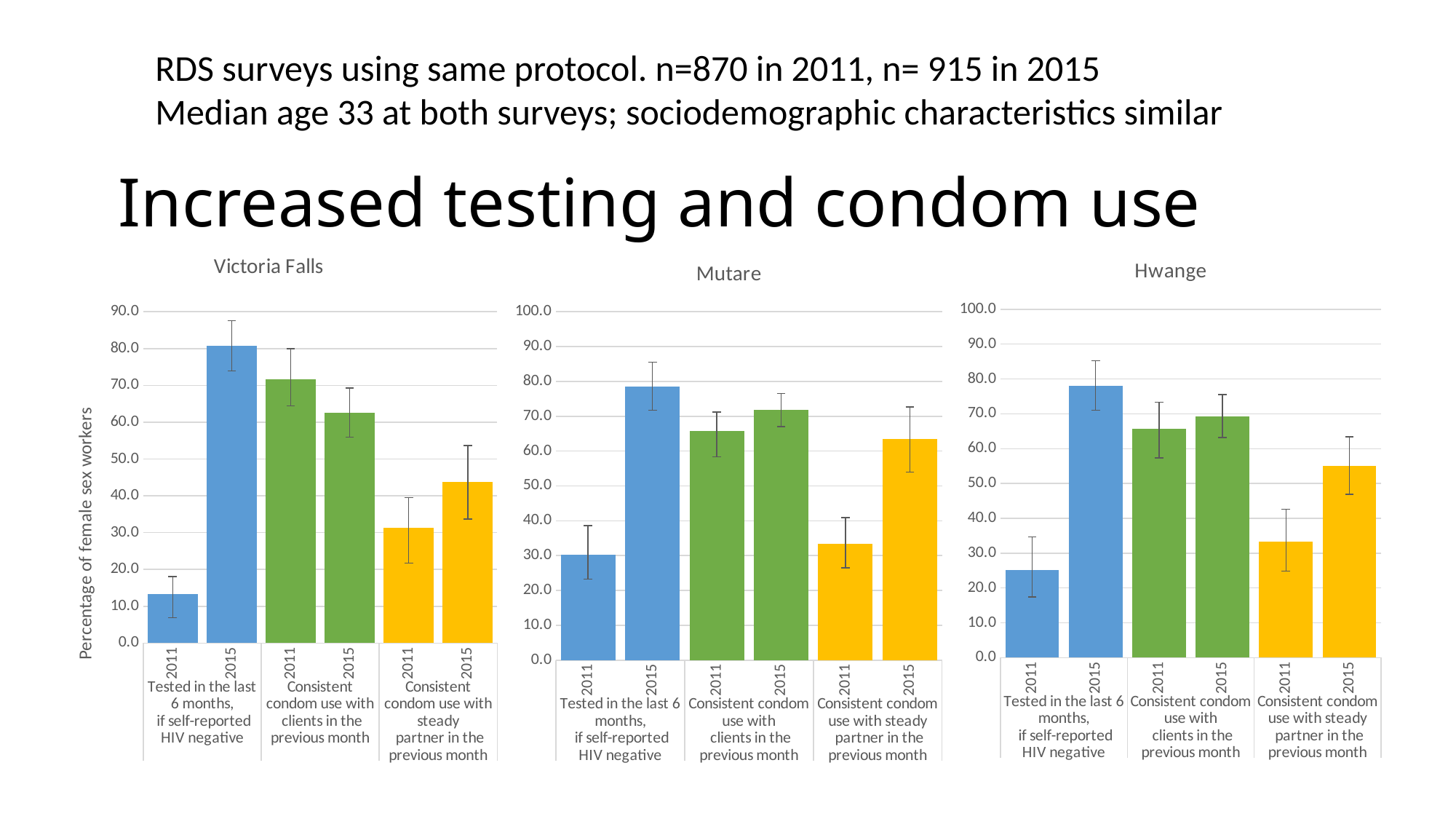
What is the y-axis label of the Victoria Falls chart? Percentage of female sex workers How many bars are plotted in the Victoria Falls chart? 6 In the Victoria Falls chart, is the 2015 value for 'Tested in the last 6 months, if self-reported HIV negative' greater or less than 70.0? greater In the Victoria Falls chart, which is larger for 'Consistent condom use with clients in the previous month': the 2011 bar or the 2015 bar? 2011 In the Hwange chart, is the 2011 value for 'Tested in the last 6 months, if self-reported HIV negative' greater or less than 30.0? less What kind of chart is the Victoria Falls chart? bar chart In the Mutare chart, which is larger for 'Tested in the last 6 months, if self-reported HIV negative': the 2011 bar or the 2015 bar? 2015 In the Mutare chart, is the 2015 value for 'Consistent condom use with steady partner in the previous month' greater or less than 50.0? greater In the Victoria Falls chart, which bar is the highest? 2015, Tested in the last 6 months, if self-reported HIV negative In the Victoria Falls chart, which bar is the lowest? 2011, Tested in the last 6 months, if self-reported HIV negative In the Mutare chart, which bar is the highest? 2015, Tested in the last 6 months, if self-reported HIV negative